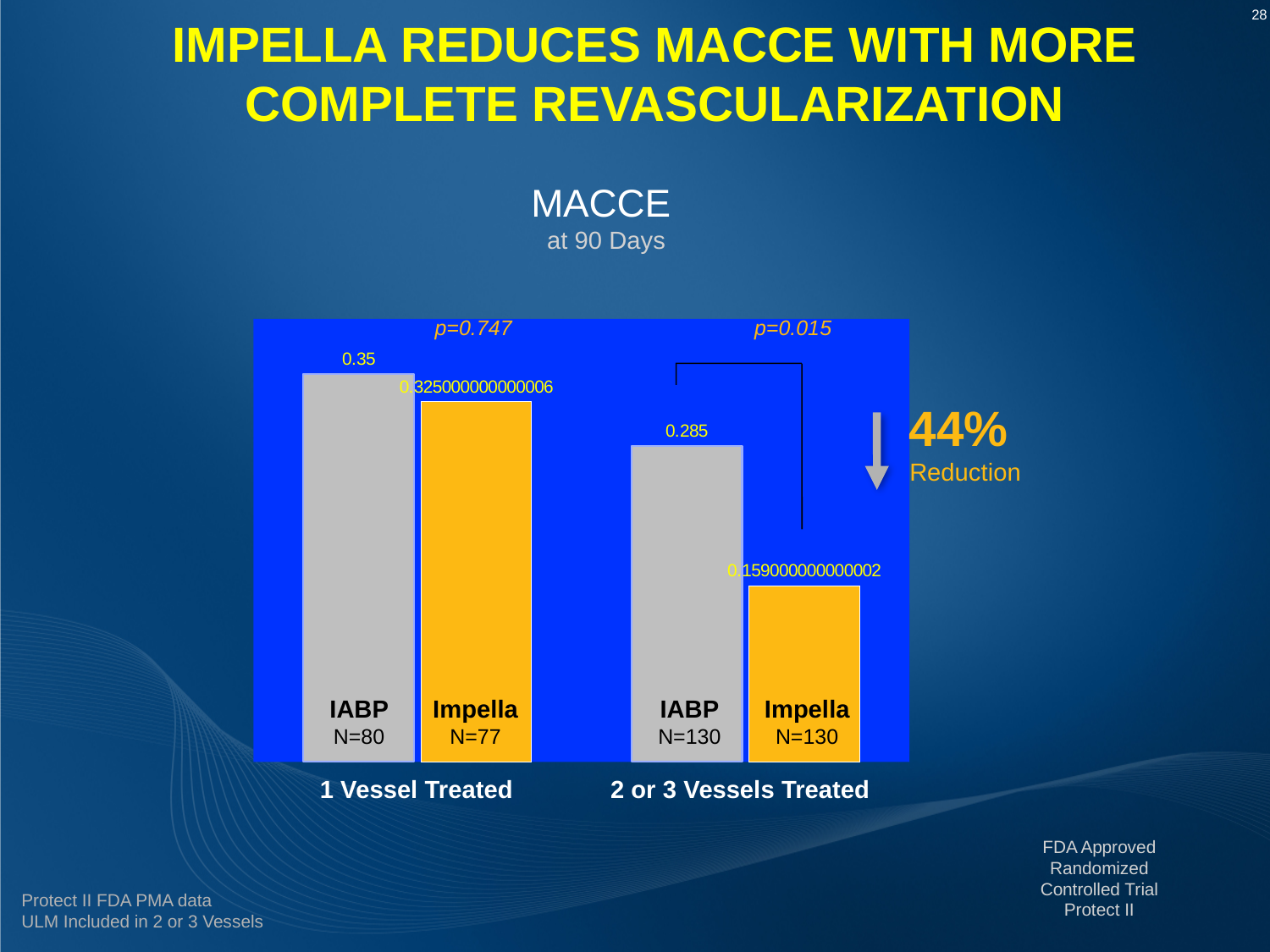
Which bar has the highest MACCE value? IABP, 1 Vessel Treated What is the MACCE value for IABP in the 1 Vessel Treated group? 0.35 How many bars are plotted in the chart? 4 What kind of chart is shown on the slide? Bar chart In the 2 or 3 Vessels Treated group, which is larger, the IABP bar or the Impella bar? IABP What value is printed above the Impella bar in the 1 Vessel Treated group? 0.325000000000006 Which bar has the lowest MACCE value? Impella, 2 or 3 Vessels Treated What is the p-value shown for the 2 or 3 Vessels Treated comparison? p=0.015 What value is printed above the Impella bar in the 2 or 3 Vessels Treated group? 0.159000000000002 What is the difference between the IABP values for 1 Vessel Treated and 2 or 3 Vessels Treated? 0.065 What is the sample size (N) for the Impella bar in the 1 Vessel Treated group? N=77 What is the MACCE value for IABP in the 2 or 3 Vessels Treated group? 0.285